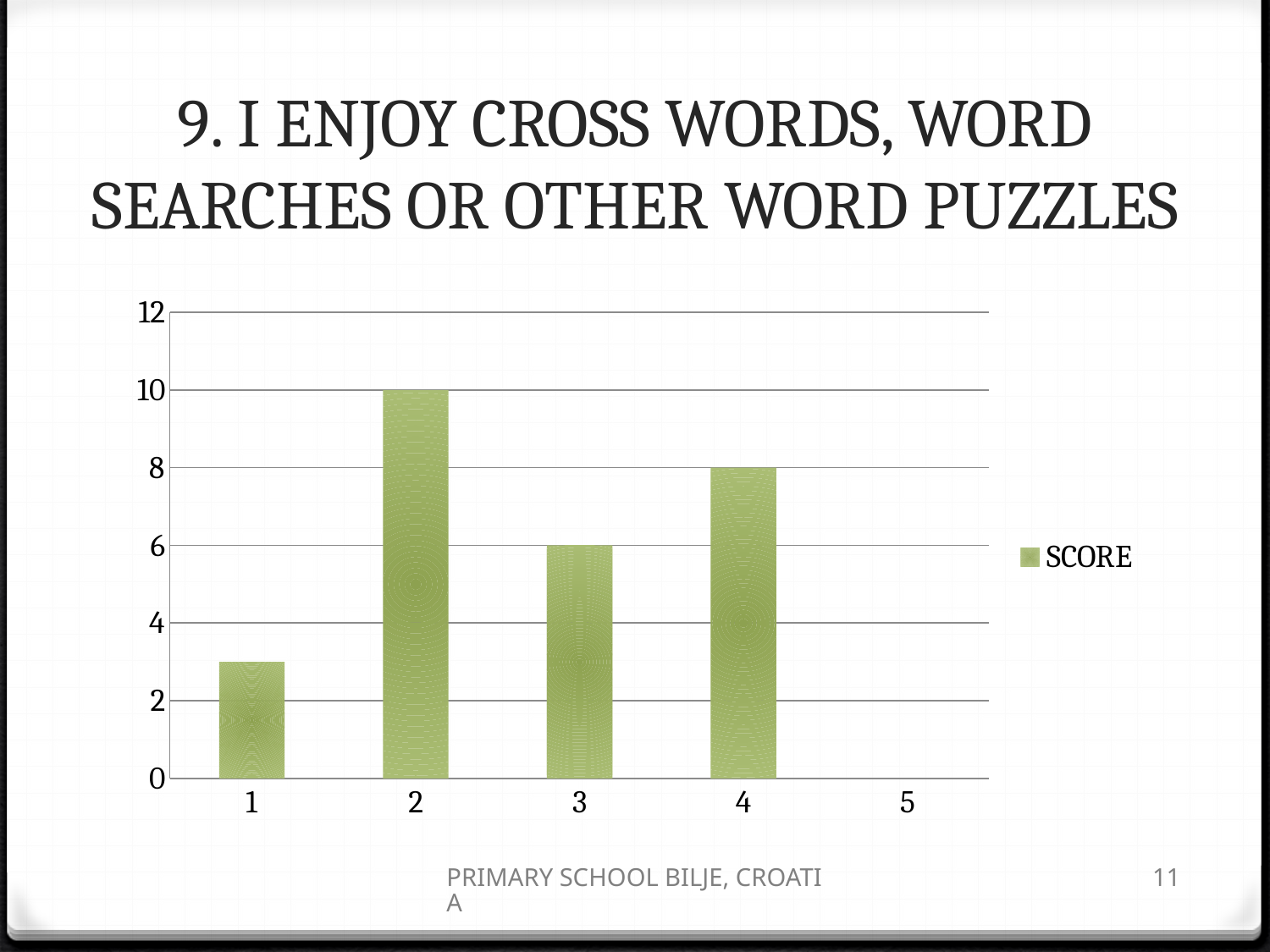
Among the categories with a visible bar, which has the lowest value? 1 What is the value for category 3? 6 What is the value for category 4? 8 Which is larger, the value for category 3 or the value for category 4? category 4 What is the difference between the values for category 2 and category 3? 4 Is the value for category 1 greater or less than 4? less What is the value for category 2? 10 Which category has the highest value? 2 What is the difference between the values for category 2 and category 4? 2 How many categories are shown on the x axis? 5 How many series does the legend list? 1 What kind of chart is shown on the slide? bar chart